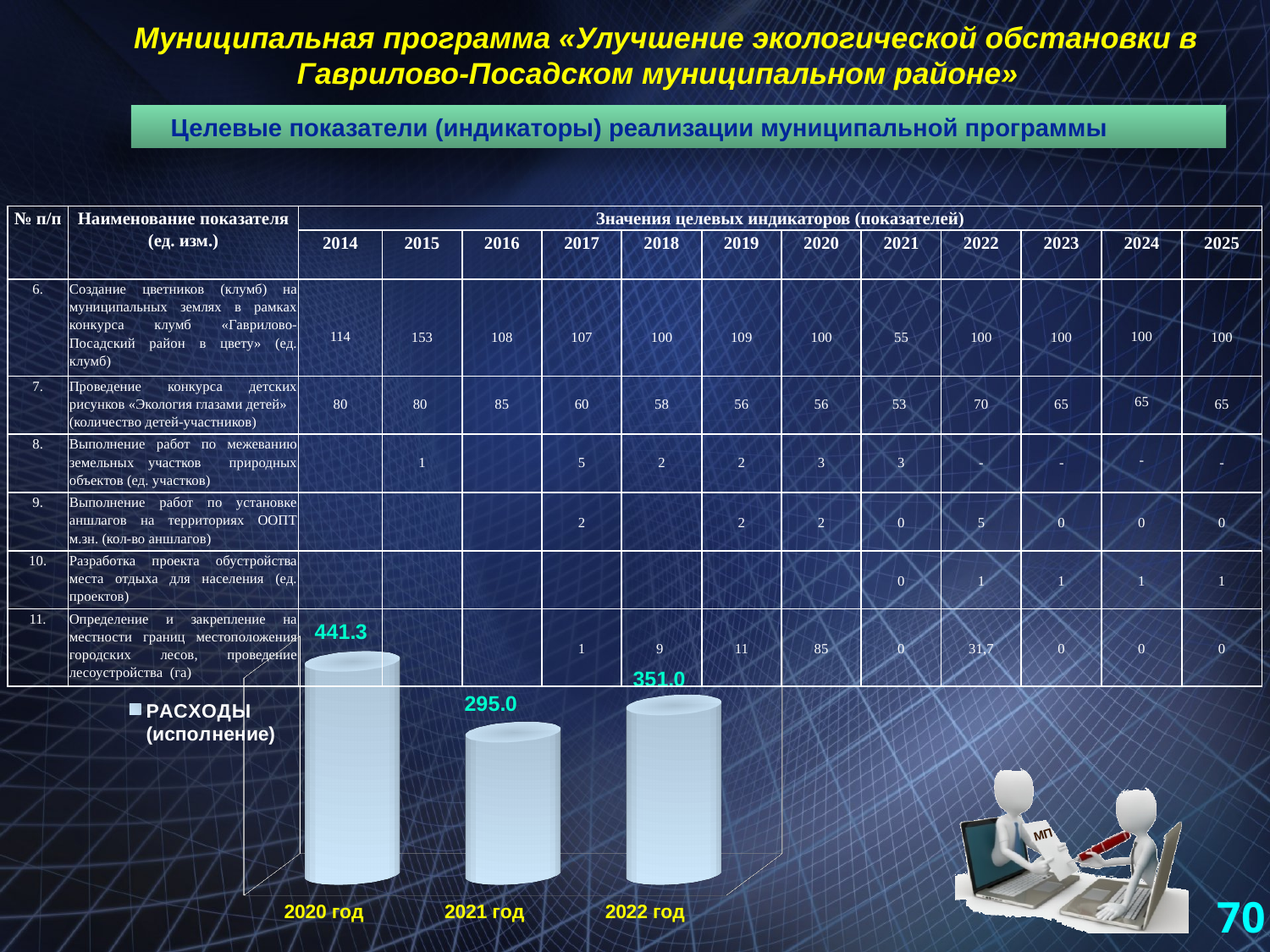
What is the legend entry of the chart at the bottom of the slide? РАСХОДЫ (исполнение) What is the value for 2021 год in the РАСХОДЫ (исполнение) chart? 295.0 Which year has the highest value in the РАСХОДЫ (исполнение) chart? 2020 год In the РАСХОДЫ (исполнение) chart, which is larger: the value for 2022 год or the value for 2021 год? 2022 год How many years are shown in the РАСХОДЫ (исполнение) chart? 3 How many series does the legend of the chart at the bottom of the slide list? 1 What kind of chart is shown at the bottom of the slide? Bar chart What is the value for 2022 год in the РАСХОДЫ (исполнение) chart? 351.0 What is the difference between the values for 2020 год and 2021 год in the РАСХОДЫ (исполнение) chart? 146.3 What is the difference between the values for 2022 год and 2021 год in the РАСХОДЫ (исполнение) chart? 56.0 Which year has the lowest value in the РАСХОДЫ (исполнение) chart? 2021 год What is the value for 2020 год in the РАСХОДЫ (исполнение) chart? 441.3